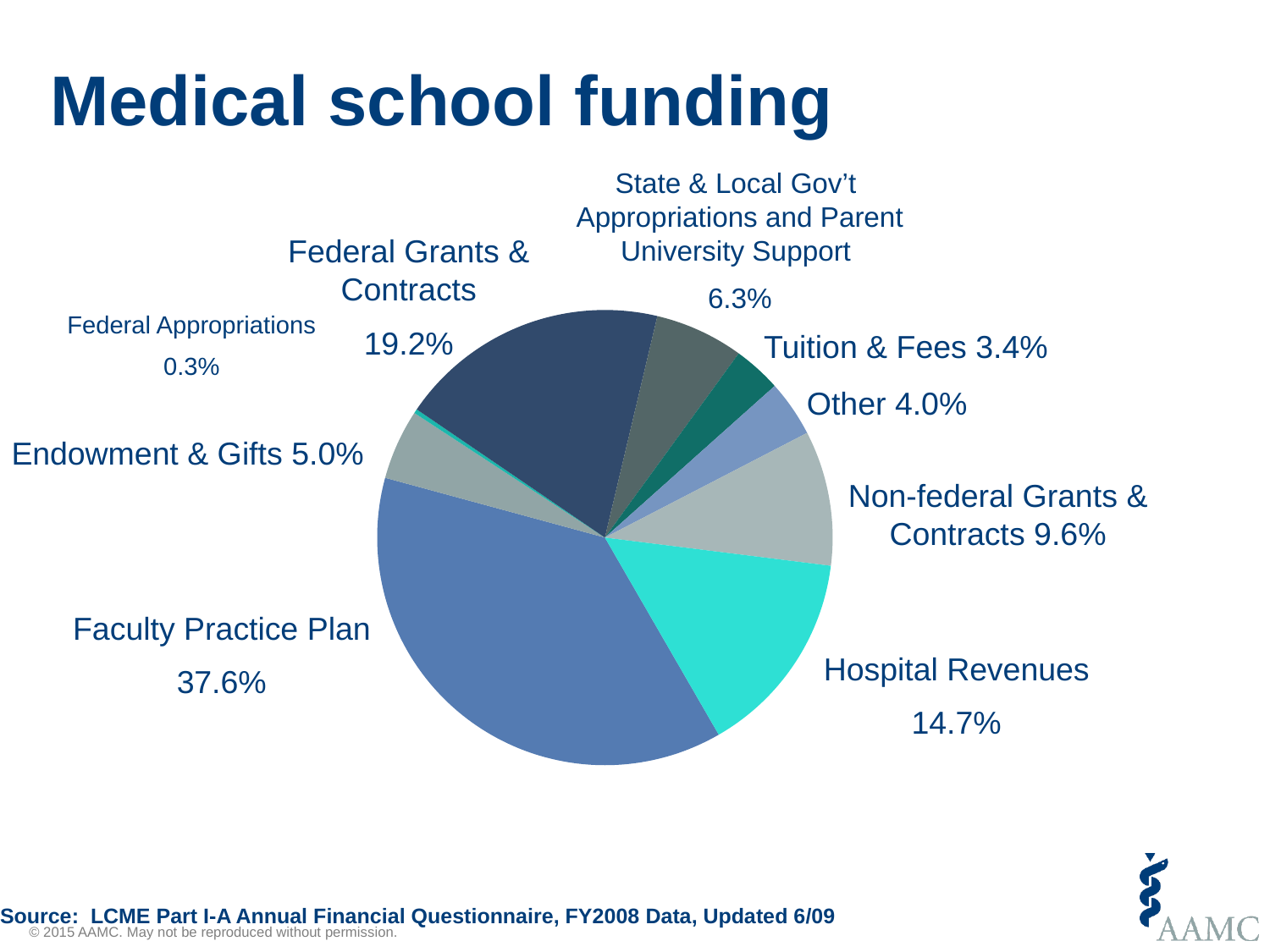
Which is larger, the share for Non-federal Grants & Contracts or the share for Endowment & Gifts? Non-federal Grants & Contracts Which funding source has the smallest share of the pie? Federal Appropriations What is the title of the slide containing the pie chart? Medical school funding What percentage is shown for Hospital Revenues? 14.7% What percentage is shown for Federal Grants & Contracts? 19.2% Which funding source has the largest share of the pie? Faculty Practice Plan What share of medical school funding comes from Faculty Practice Plan? 37.6% What percentage is shown for State & Local Gov't Appropriations and Parent University Support? 6.3% How many funding categories are shown in the pie chart? 9 What kind of chart is shown on the slide? Pie chart What percentage is shown for Federal Appropriations? 0.3% What is the difference in percentage points between Federal Grants & Contracts and Hospital Revenues? 4.5